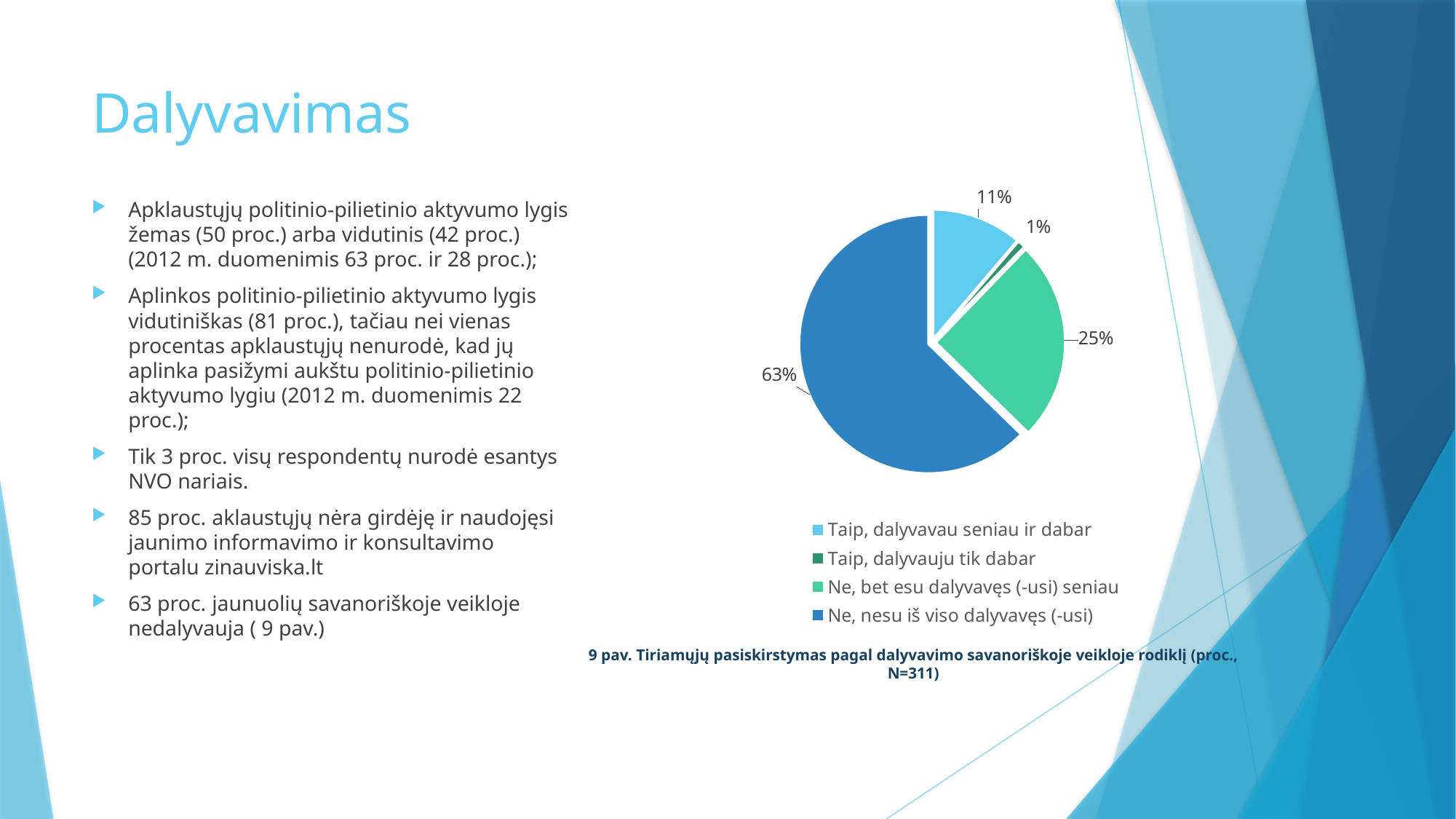
What kind of chart is shown on the slide? pie chart What is the difference in percentage points between "Ne, nesu iš viso dalyvavęs (-usi)" and "Ne, bet esu dalyvavęs (-usi) seniau"? 38 What share of respondents answered "Ne, nesu iš viso dalyvavęs (-usi)"? 63% Which is larger: the share for "Taip, dalyvavau seniau ir dabar" or the share for "Ne, bet esu dalyvavęs (-usi) seniau"? Ne, bet esu dalyvavęs (-usi) seniau Which category has the largest slice of the pie? Ne, nesu iš viso dalyvavęs (-usi) What is the sample size (N) stated in the chart caption? 311 Which category has the smallest slice of the pie? Taip, dalyvauju tik dabar What share of respondents answered "Ne, bet esu dalyvavęs (-usi) seniau"? 25% What share of respondents answered "Taip, dalyvavau seniau ir dabar"? 11% What share of respondents answered "Taip, dalyvauju tik dabar"? 1% What is the combined share of the two "Taip" categories? 12% How many categories does the pie chart show? 4